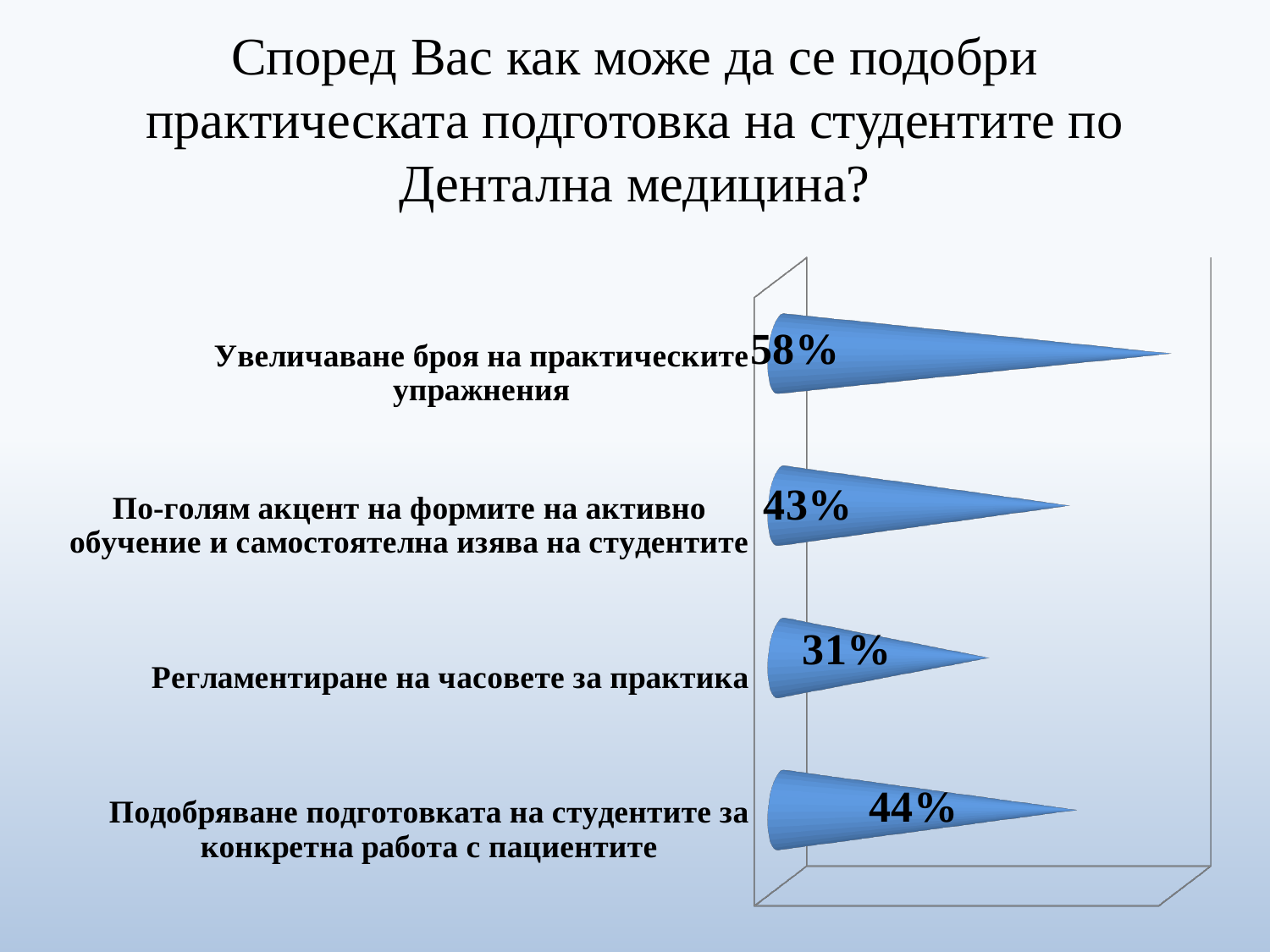
Which category has the lowest value? Регламентиране на часовете за практика What value is shown for "Регламентиране на часовете за практика"? 31% What colour are the bars in the chart? Blue What is the difference between the values for "Подобряване подготовката на студентите за конкретна работа с пациентите" and "По-голям акцент на формите на активно обучение и самостоятелна изява на студентите"? 1% What percentage is shown for "Увеличаване броя на практическите упражнения"? 58% How many categories are shown in the chart? 4 What kind of chart is shown on the slide? Bar chart What value is shown for "Подобряване подготовката на студентите за конкретна работа с пациентите"? 44% Which is larger: the value for "Увеличаване броя на практическите упражнения" or for "По-голям акцент на формите на активно обучение и самостоятелна изява на студентите"? Увеличаване броя на практическите упражнения Which category has the highest value? Увеличаване броя на практическите упражнения What percentage is shown for "По-голям акцент на формите на активно обучение и самостоятелна изява на студентите"? 43% What is the difference between the values for "Увеличаване броя на практическите упражнения" and "Регламентиране на часовете за практика"? 27%